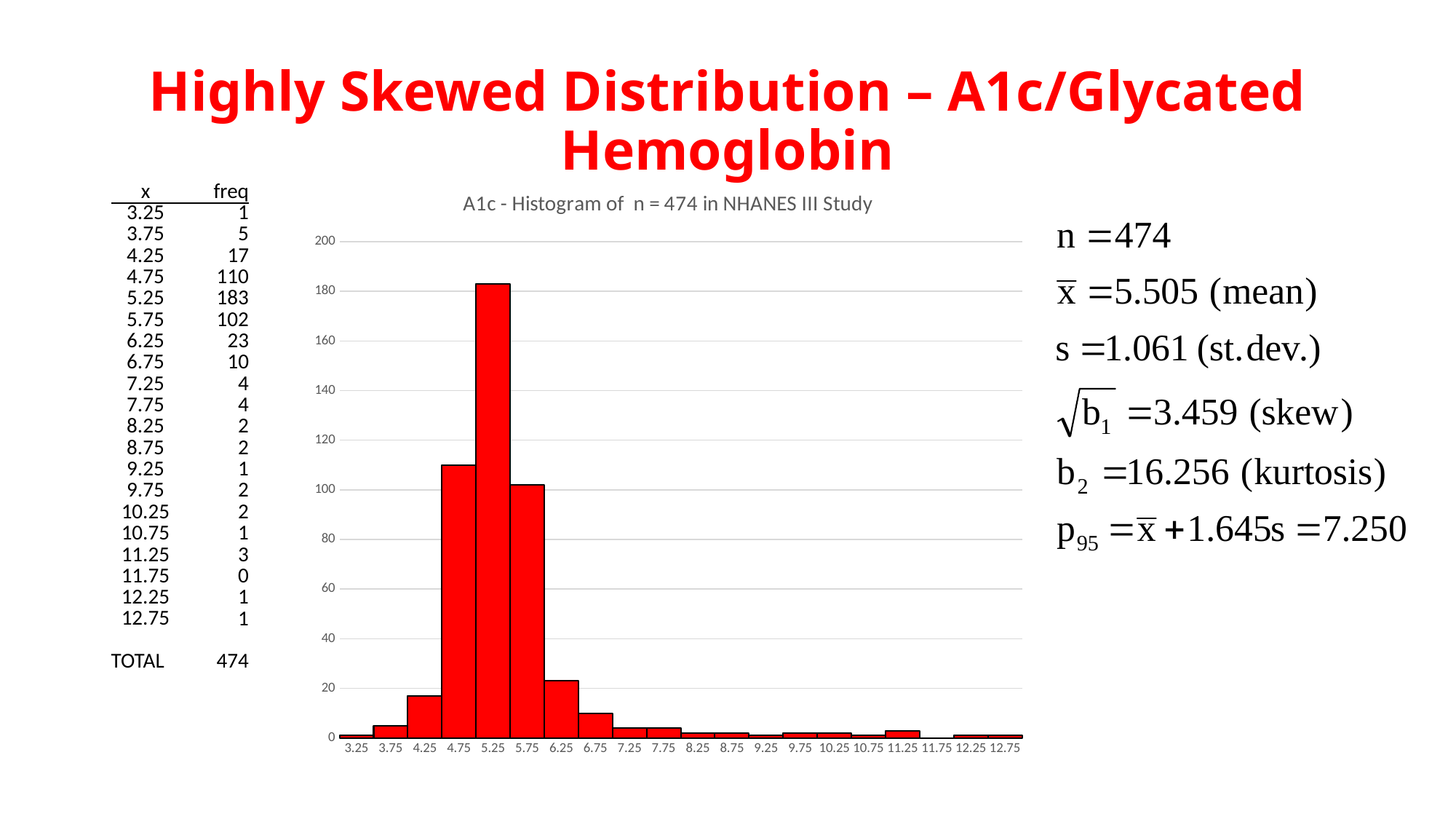
What is the title of the chart? A1c - Histogram of n = 474 in NHANES III Study What kind of chart is shown on the slide? bar chart Is the frequency for x = 4.75 greater or less than 120? less Which has the larger frequency, x = 6.25 or x = 6.75? 6.25 Which has the larger frequency, x = 4.75 or x = 5.75? 4.75 Do the frequencies rise or fall along the x axis from 5.25 to 12.75? fall Is the frequency for x = 6.25 greater or less than 40? less What is the frequency for x = 5.25 according to the table on the slide? 183 Which x category has the lowest frequency in the histogram? 11.75 How many x categories are shown along the horizontal axis of the histogram? 20 Which x category has the highest frequency in the histogram? 5.25 Is the frequency for x = 5.25 greater or less than 160? greater